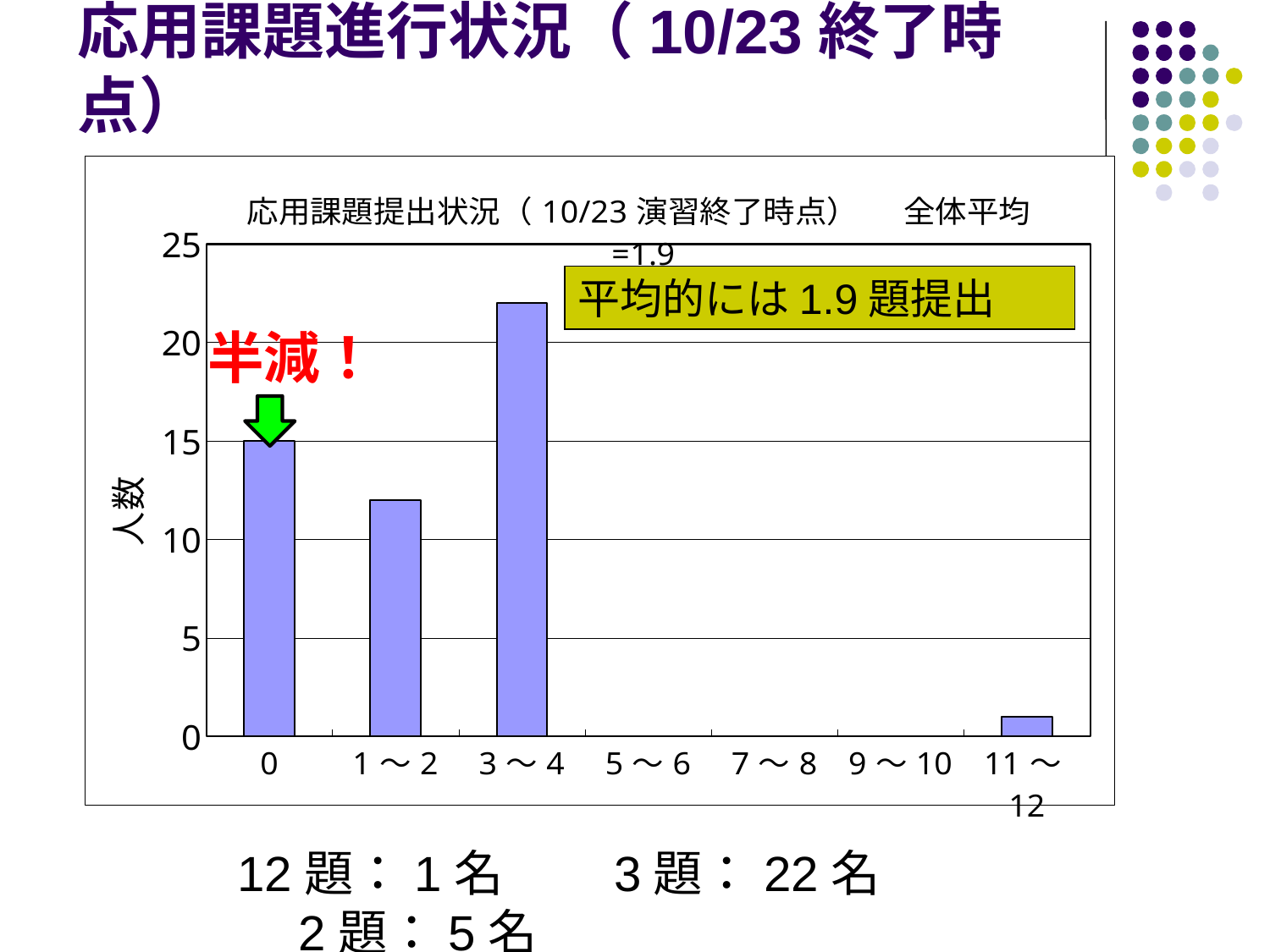
What overall average (全体平均) is stated in the chart title? 1.9 Is the value for the category 11～12 greater or less than 5? less What is the value (人数) for the category 0? 15 Is the value for the category 3～4 greater or less than 20? greater What type of chart is shown on the slide? bar chart Which is larger, the value for category 0 or the value for category 1～2? 0 Is the value for the category 1～2 greater or less than 10? greater What is the label on the y axis of the chart? 人数 What is the value for the category 7～8? 0 Which category has the highest value in the chart? 3～4 How many categories are shown on the x axis of the chart? 7